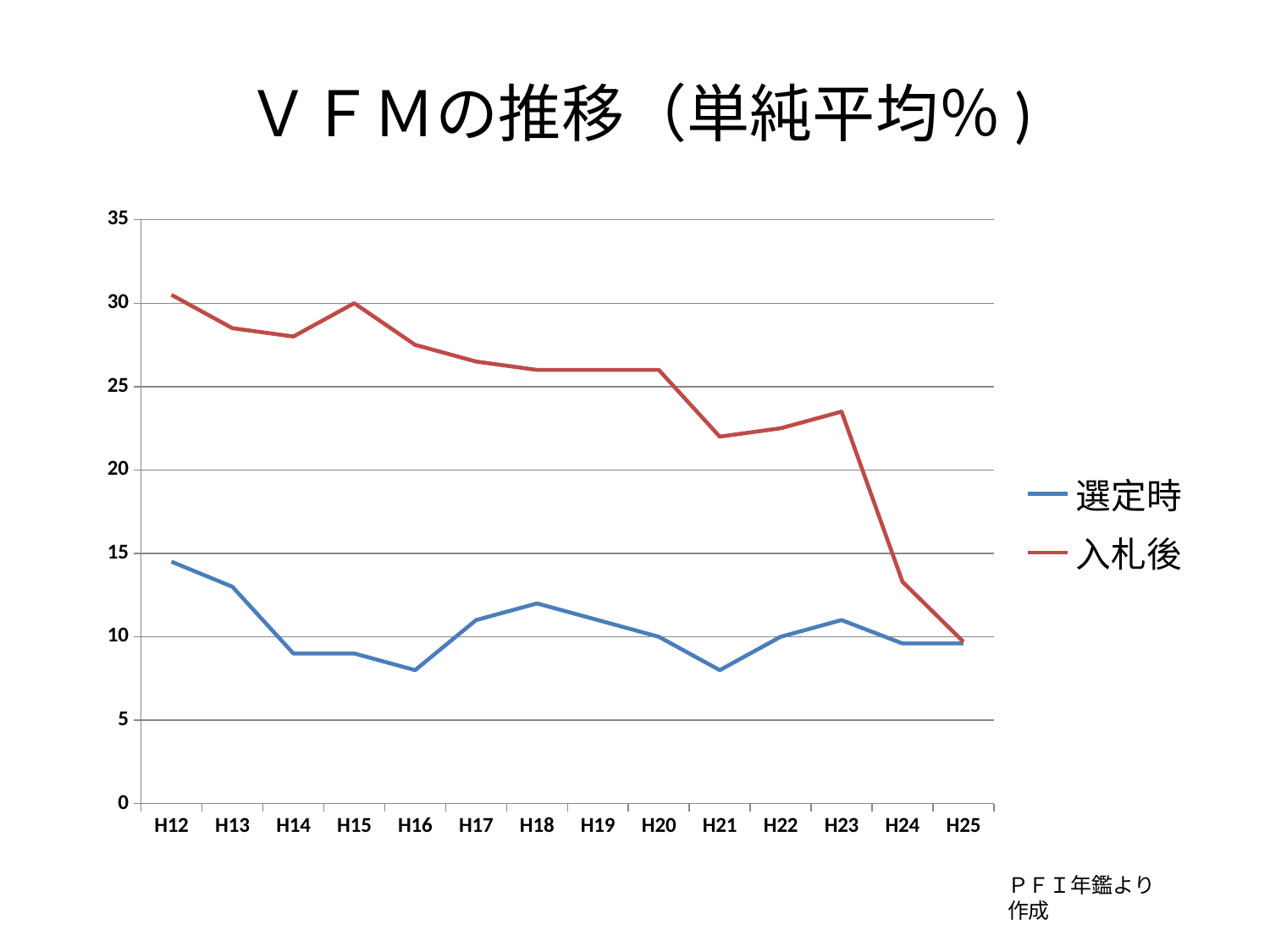
What kind of chart is shown on the slide? line chart How many points (years) are plotted along the x axis? 14 Is the value for 選定時 at H18 greater or less than 10? greater Is the value for 入札後 at H21 greater or less than 25? less Does the 入札後 line generally rise or fall from H12 to H25? fall What is the title of the chart? ＶＦＭの推移（単純平均％） Which series is drawn in red? 入札後 Is the value for 入札後 at H24 greater or less than 15? less How many series does the legend list? 2 Which year has the highest value for 選定時? H12 Which year has the lowest value for 入札後? H25 At H12, which series has the larger value, 選定時 or 入札後? 入札後